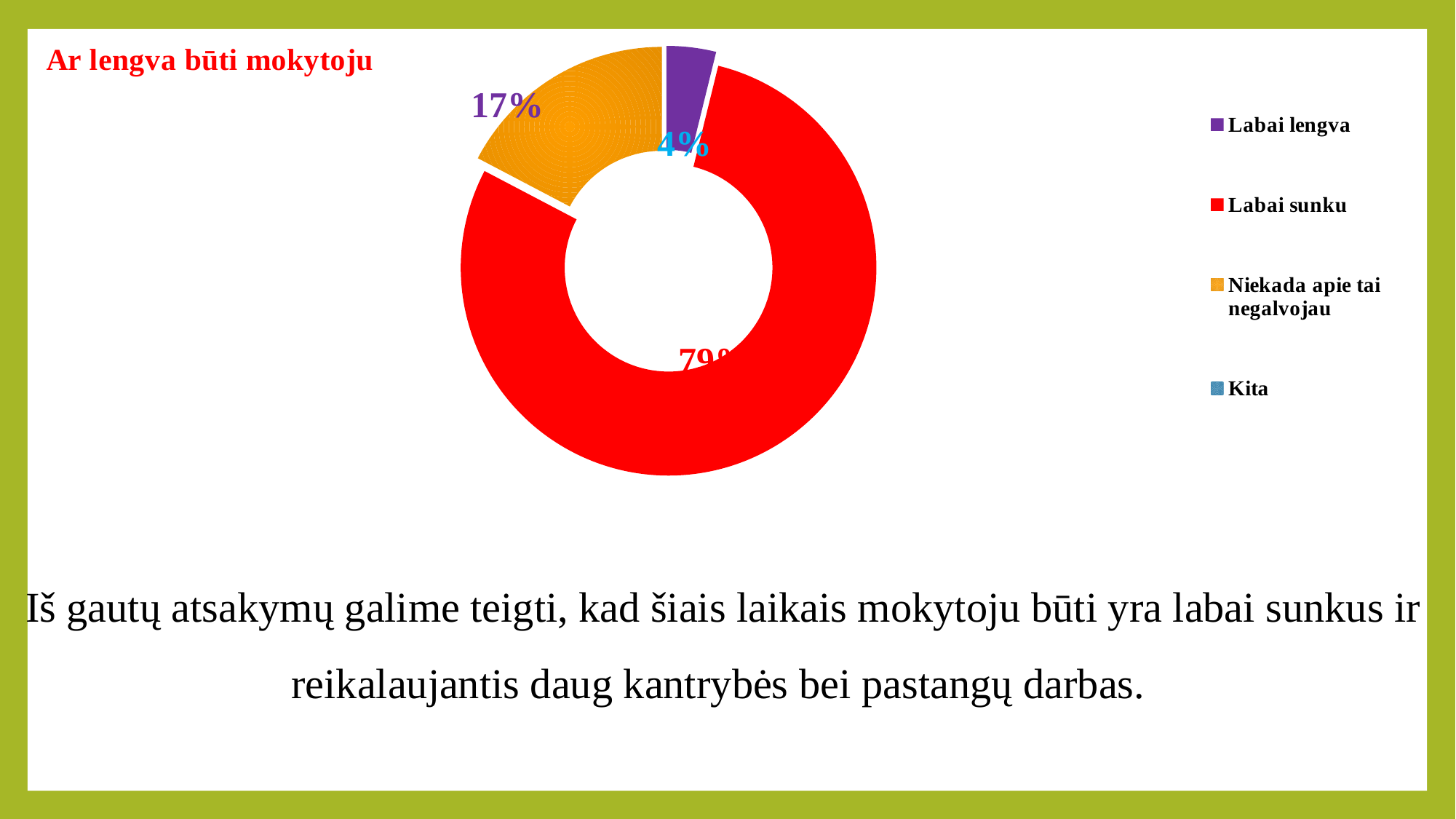
What is the title of the chart? Ar lengva būti mokytoju What type of chart is shown on the slide? Doughnut chart Which category has the largest share of the chart? Labai sunku Which is larger: the share for 'Labai sunku' or the share for 'Niekada apie tai negalvojau'? Labai sunku What percentage is shown for the 'Labai lengva' slice? 4% How many categories does the chart legend list? 4 By how many percentage points does the 'Niekada apie tai negalvojau' share exceed the 'Labai lengva' share? 13 percentage points What percentage is shown for the 'Niekada apie tai negalvojau' slice? 17% Which is larger: the share for 'Niekada apie tai negalvojau' or the share for 'Labai lengva'? Niekada apie tai negalvojau Which colour represents 'Labai sunku' in the chart? Red